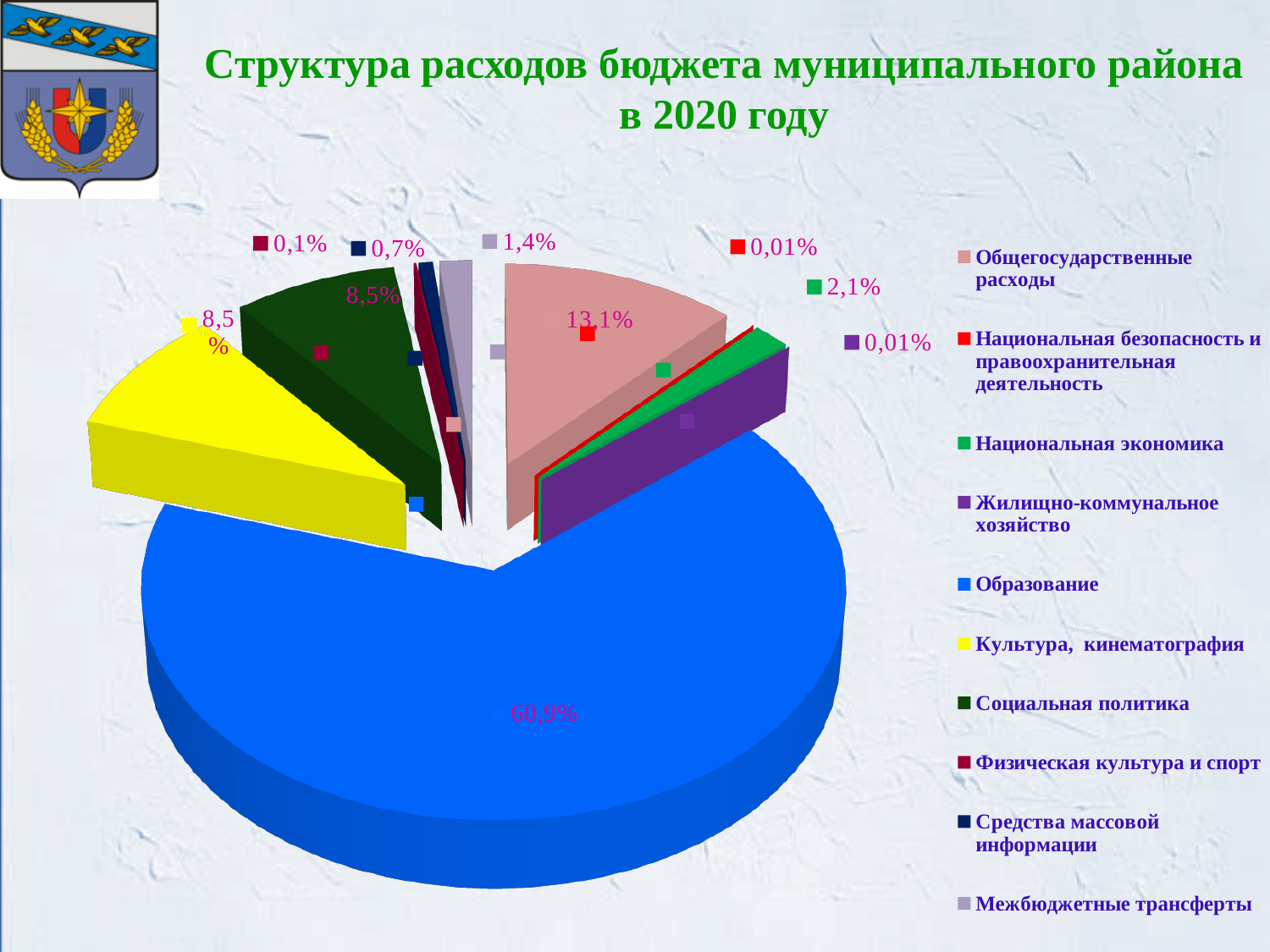
Which category has the largest share of the pie? Образование What share is shown for Общегосударственные расходы? 13,1% What share is shown for Национальная экономика? 2,1% What share is shown for Межбюджетные трансферты? 1,4% Which has the larger share: Национальная экономика or Межбюджетные трансферты? Национальная экономика What share of the budget expenditure goes to Образование? 60,9% What kind of chart is shown on the slide? pie chart How many categories does the legend of the pie chart list? 10 What share is shown for Средства массовой информации? 0,7% What is the title of the chart? Структура расходов бюджета муниципального района в 2020 году What share is shown for Физическая культура и спорт? 0,1% By how many percentage points does the share of Образование exceed that of Общегосударственные расходы? 47,8%